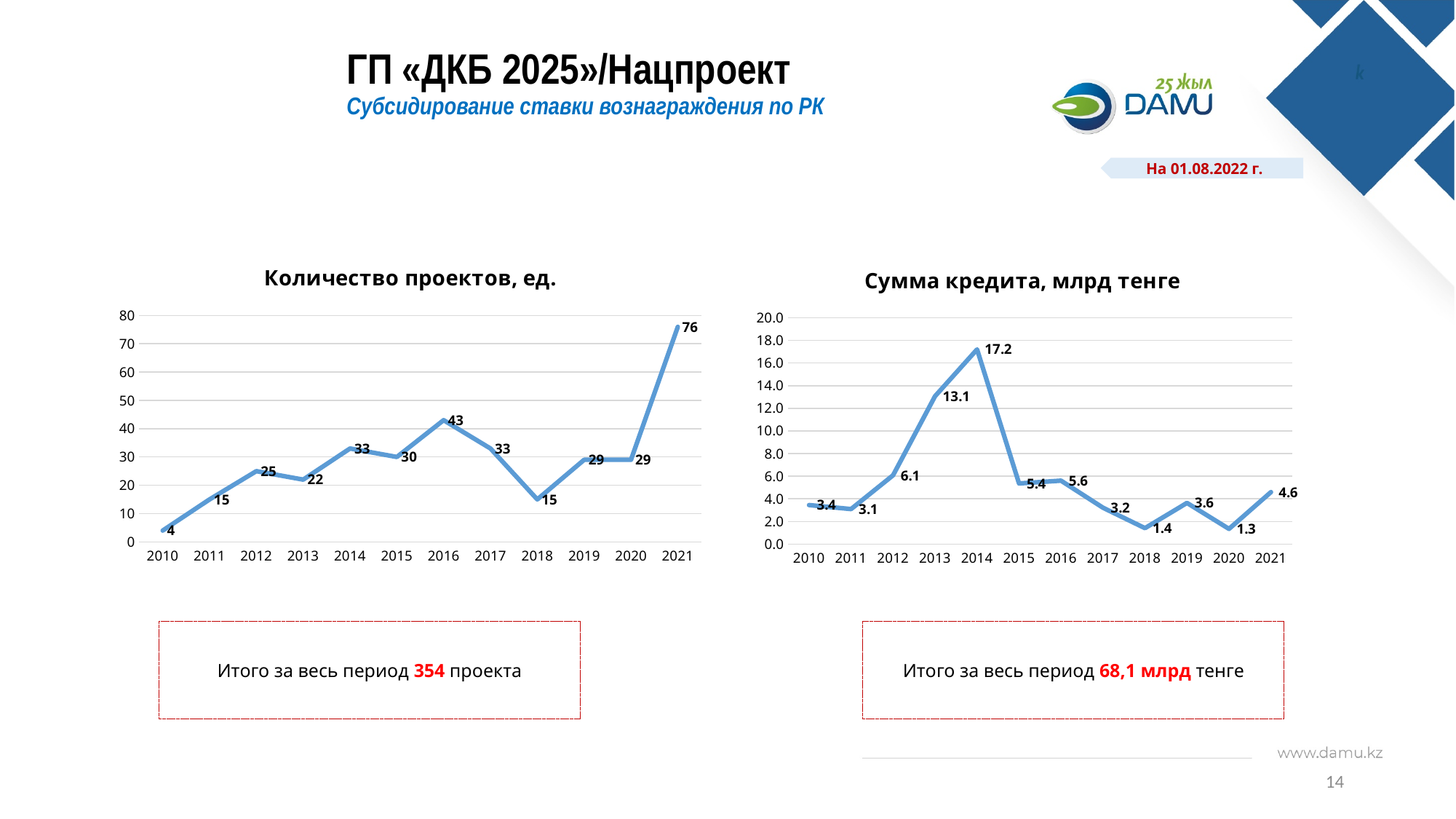
In the chart titled "Сумма кредита, млрд тенге", which year has the lowest value? 2020 In the chart titled "Сумма кредита, млрд тенге", do the values rise or fall from 2014 to 2015? fall In the chart titled "Количество проектов, ед.", what is the difference between the values for 2021 and 2020? 47 In the chart titled "Сумма кредита, млрд тенге", which is larger, the value for 2013 or the value for 2015? 2013 In the chart titled "Количество проектов, ед.", how many years are plotted on the x axis? 12 In the chart titled "Количество проектов, ед.", which year has the lowest value? 2010 In the chart titled "Количество проектов, ед.", what is the value for 2016? 43 In the chart titled "Сумма кредита, млрд тенге", what is the value for 2014? 17.2 In the chart titled "Сумма кредита, млрд тенге", what is the difference between the values for 2014 and 2013? 4.1 In the chart titled "Количество проектов, ед.", what is the value for 2021? 76 What kind of chart is the chart titled "Сумма кредита, млрд тенге"? line chart In the chart titled "Сумма кредита, млрд тенге", what is the value for 2018? 1.4